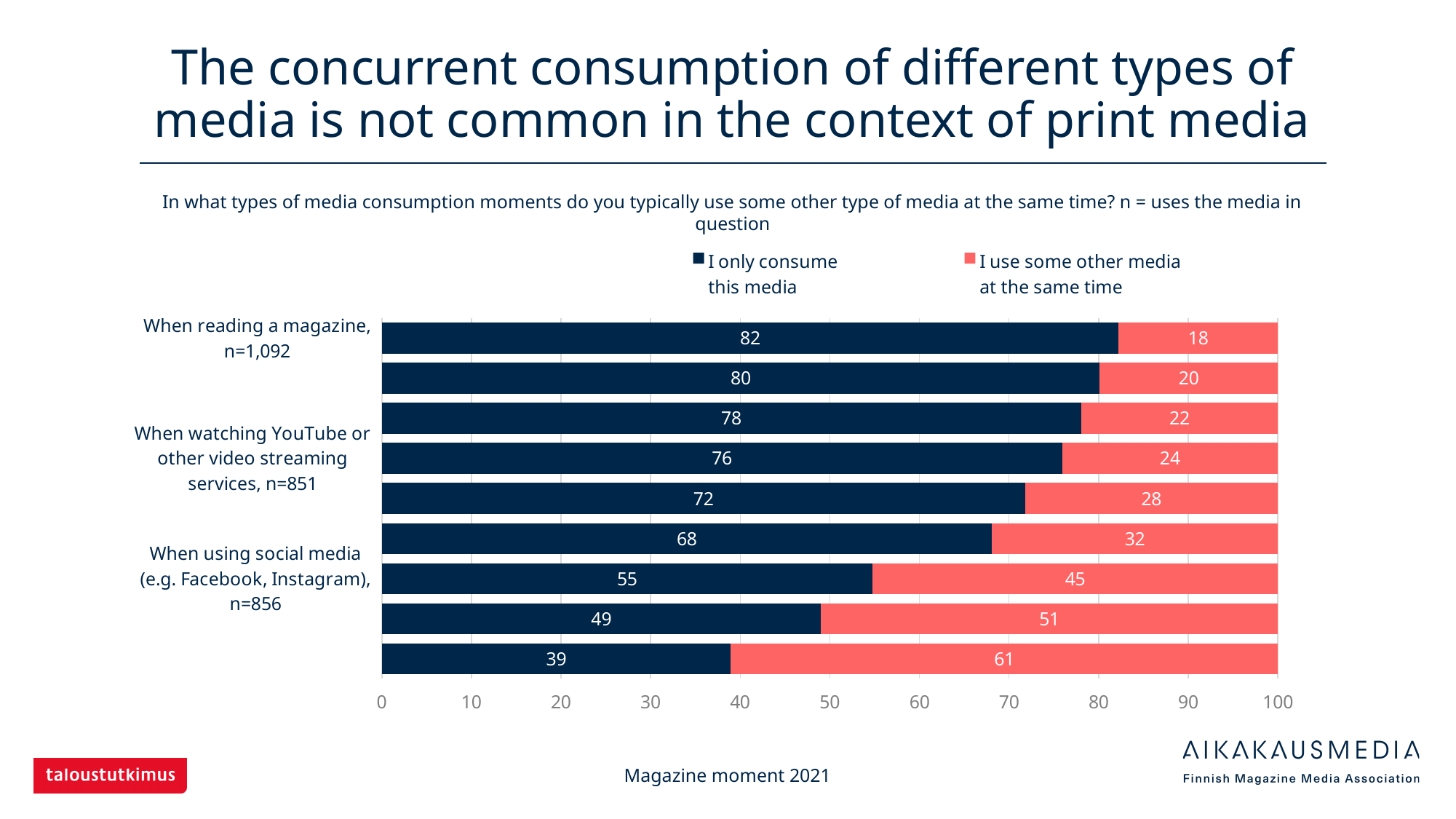
What is the value for "I use some other media at the same time" when reading a magazine (n=1,092)? 18 What is the total of the stacked bar for when reading a magazine (n=1,092)? 100 What is the value for "I only consume this media" when watching YouTube or other video streaming services (n=851)? 76 What is the value for "I use some other media at the same time" when using social media (n=856)? 45 What is the value for "I only consume this media" when using social media (n=856)? 55 What is the difference between the "I only consume this media" values for reading a magazine and using social media? 27 How many series does the legend list? 2 What is the value for "I use some other media at the same time" when watching YouTube or other video streaming services (n=851)? 24 Which has a larger "I only consume this media" value: when reading a magazine or when using social media? When reading a magazine How many bars are plotted in the chart? 9 What kind of chart is shown on the slide? Bar chart What is the value for "I only consume this media" when reading a magazine (n=1,092)? 82